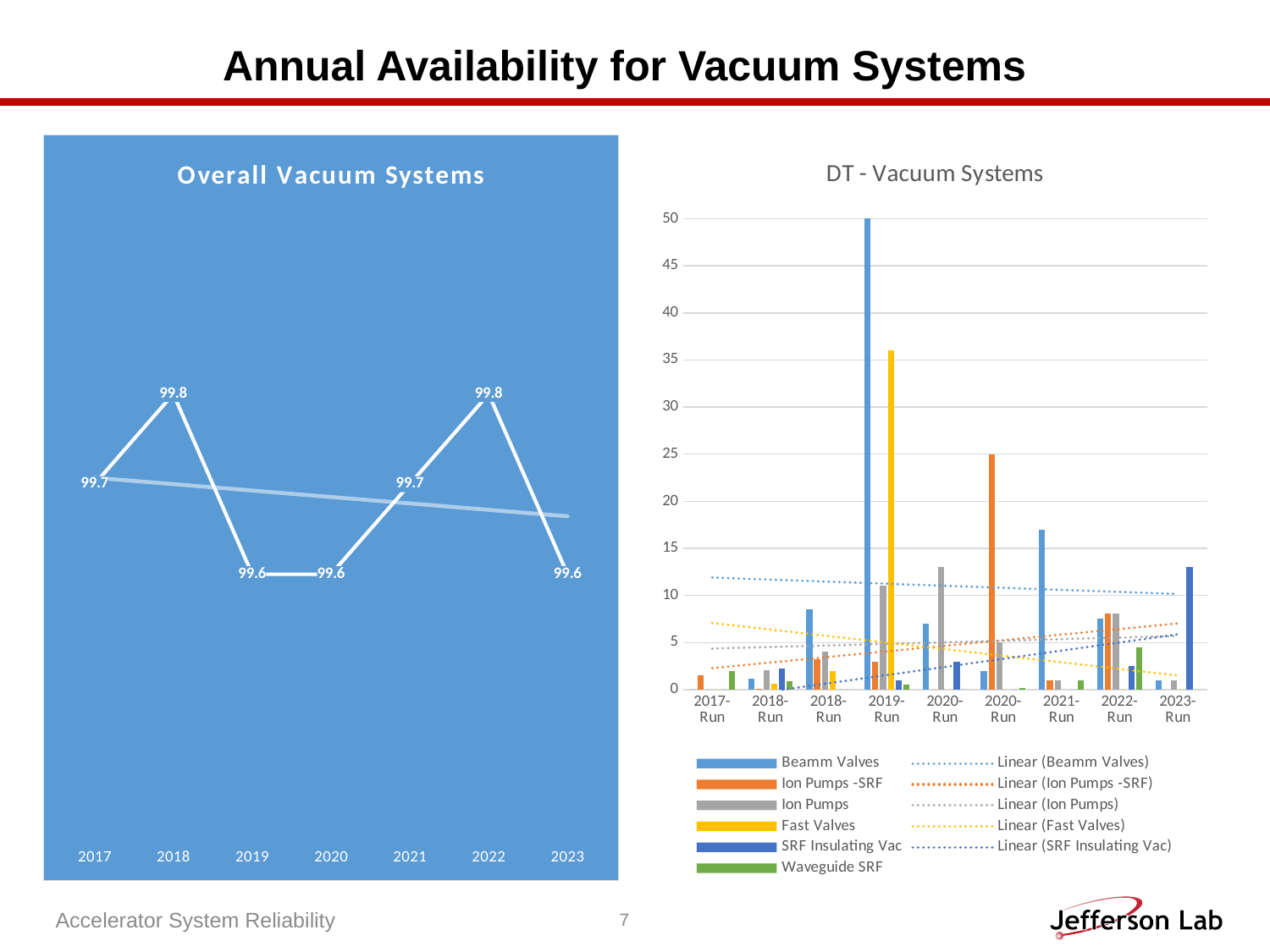
In the Overall Vacuum Systems chart, what is the value for 2018? 99.8 In the DT - Vacuum Systems chart, is the Beamm Valves bar for 2019-Run greater or less than 45? greater In the DT - Vacuum Systems chart, is the Ion Pumps -SRF bar for the second 2020-Run category greater or less than 20? greater In the DT - Vacuum Systems chart, is the Fast Valves bar for 2019-Run greater or less than 30? greater What kind of chart is the Overall Vacuum Systems chart? line chart In the Overall Vacuum Systems chart, what is the difference between the 2018 value and the 2019 value? 0.2 In the DT - Vacuum Systems chart, how many categories are shown on the x axis? 9 In the Overall Vacuum Systems chart, how many years are plotted on the x axis? 7 In the Overall Vacuum Systems chart, which year has the larger value, 2020 or 2021? 2021 In the Overall Vacuum Systems chart, what is the value for 2023? 99.6 In the DT - Vacuum Systems chart, which category contains the tallest bar? 2019-Run What kind of chart is the DT - Vacuum Systems chart? bar chart